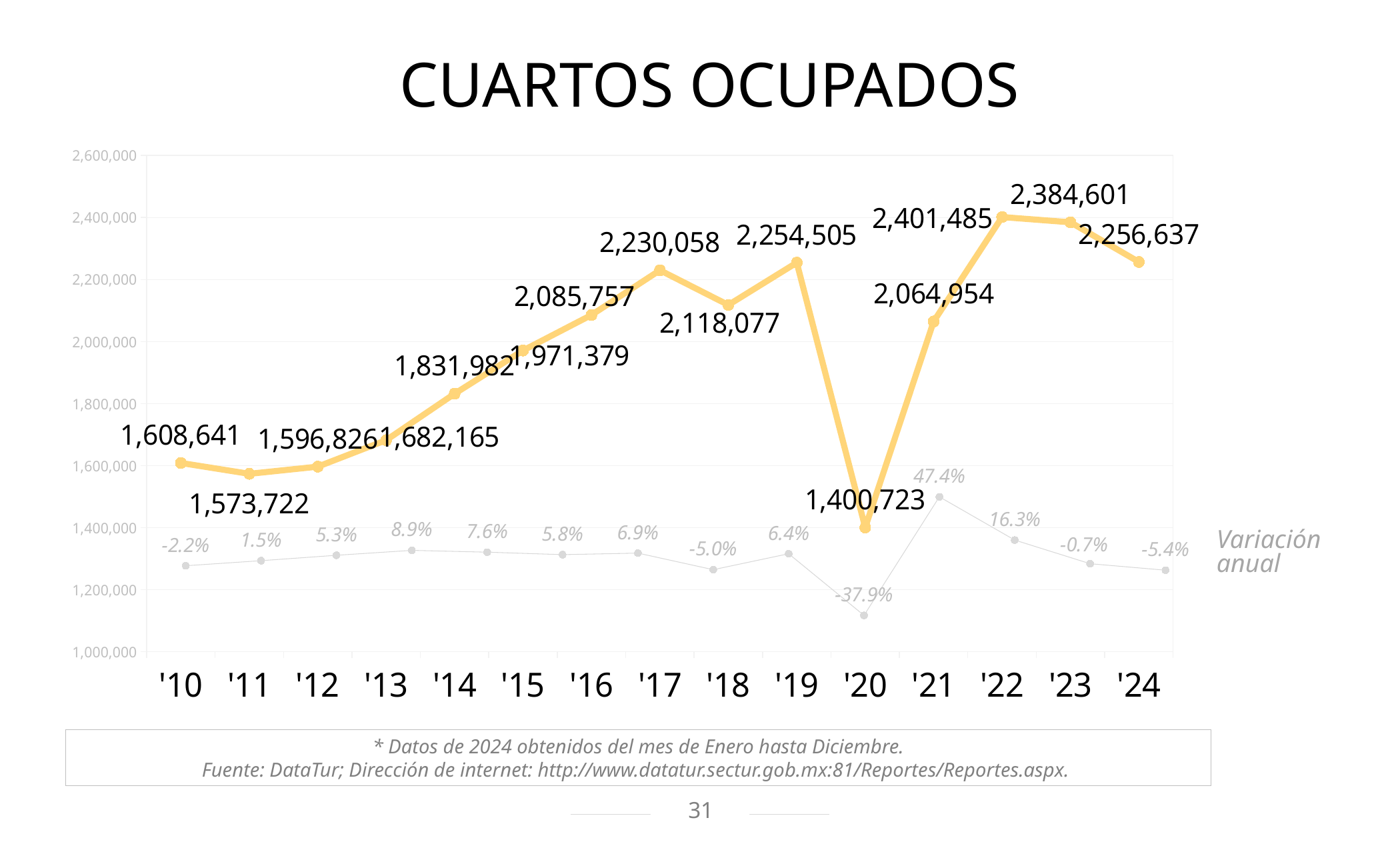
How many years are shown on the x axis? 15 Which year has the highest value of cuartos ocupados? '22 Which year has the larger value of cuartos ocupados, '17 or '18? '17 What is the variación anual shown for '21? 47.4% What is the title of the chart? CUARTOS OCUPADOS What is the value of cuartos ocupados for '14? 1,831,982 What is the value of cuartos ocupados for '20? 1,400,723 What is the variación anual shown for '20? -37.9% What is the value of cuartos ocupados for '22? 2,401,485 What is the difference in cuartos ocupados between '22 and '23? 16,884 What type of chart is shown on the slide? line chart Which year has the lowest value of cuartos ocupados? '20